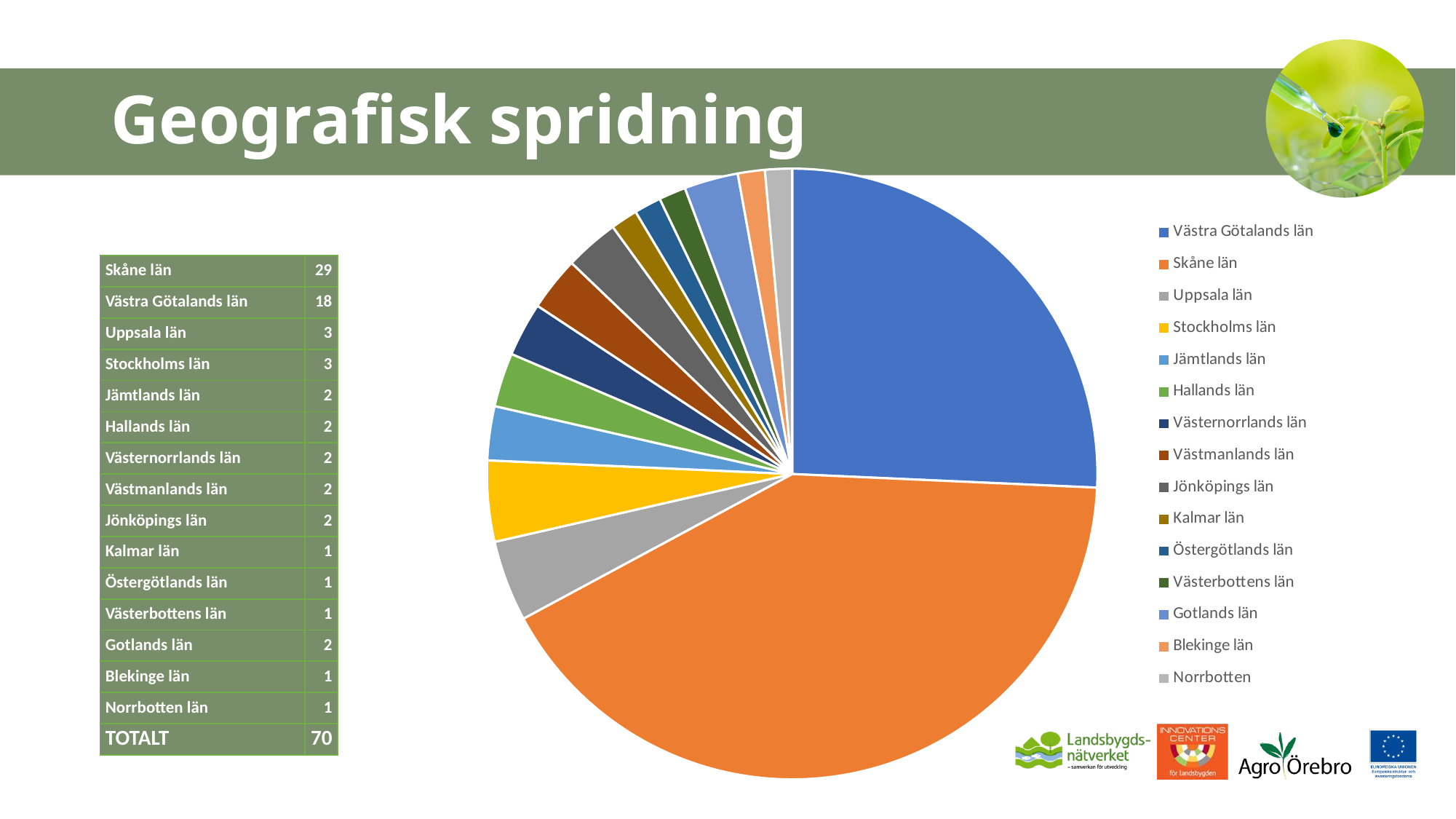
What is the value for Gotlands län? 2 What colour is the slice for Skåne län? orange What kind of chart is shown on the slide? pie chart Which county has the largest slice in the pie chart? Skåne län How many categories (slices) does the pie chart have? 15 What is the last entry listed in the legend? Norrbotten What is the difference between the values for Skåne län and Västra Götalands län? 11 Which is larger, the value for Hallands län or Kalmar län? Hallands län What is the total (TOTALT) of all counties? 70 What is the value for Västra Götalands län? 18 What is the value for Skåne län? 29 Which is larger, the value for Västra Götalands län or Uppsala län? Västra Götalands län